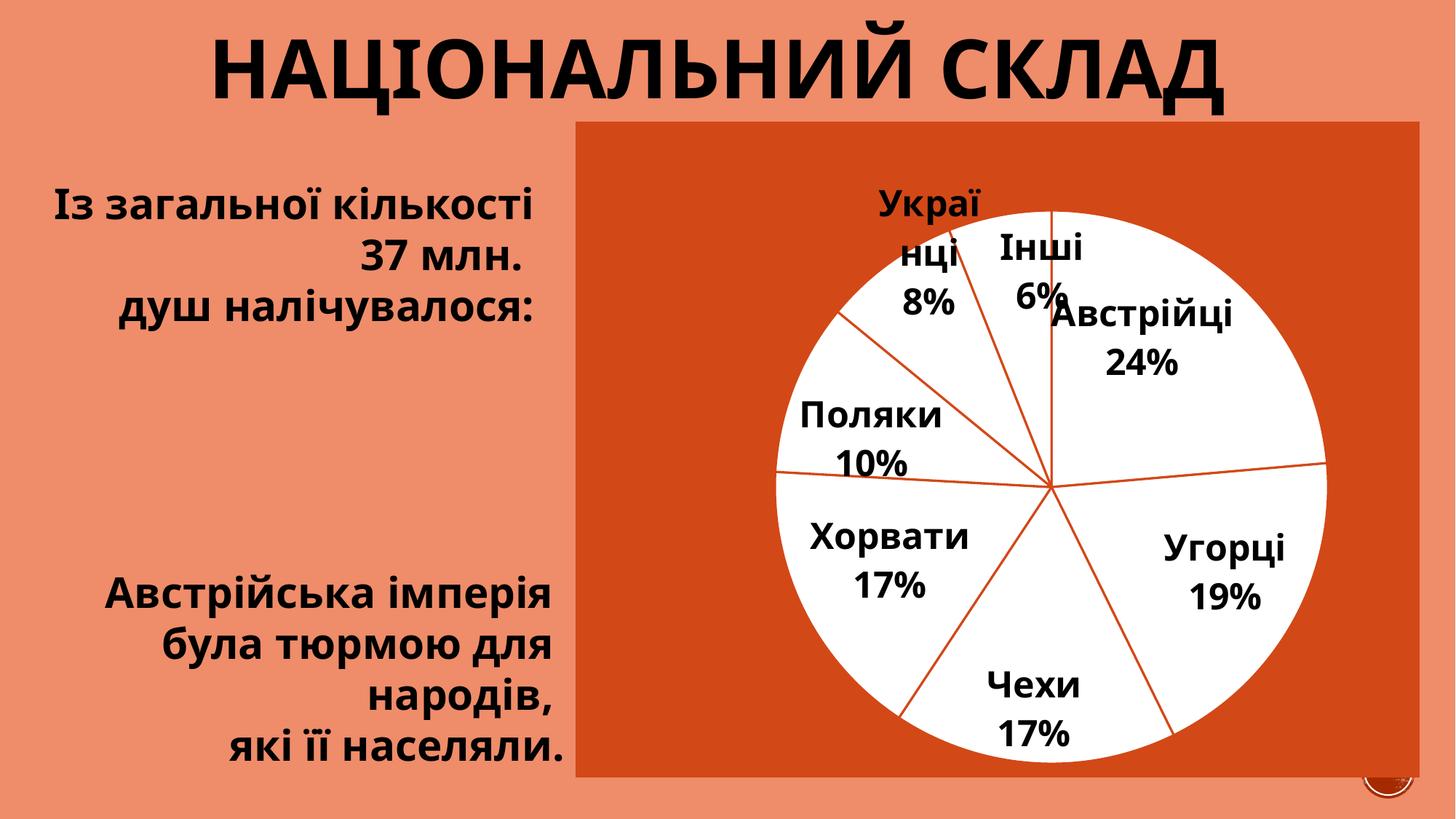
What share of the pie does Угорці have? 19% Which category has the largest slice of the pie? Австрійці What share of the pie does Поляки have? 10% What share of the pie does Українці have? 8% Which category has the smallest slice of the pie? Інші Which is larger, the share for Поляки or the share for Українці? Поляки What is the difference in percentage points between Австрійці and Угорці? 5 What kind of chart is shown on the slide? pie chart What share of the pie does Австрійці have? 24% What is the title of the slide containing the chart? НАЦІОНАЛЬНИЙ СКЛАД What share of the pie does Інші have? 6% How many categories are shown in the pie chart? 7